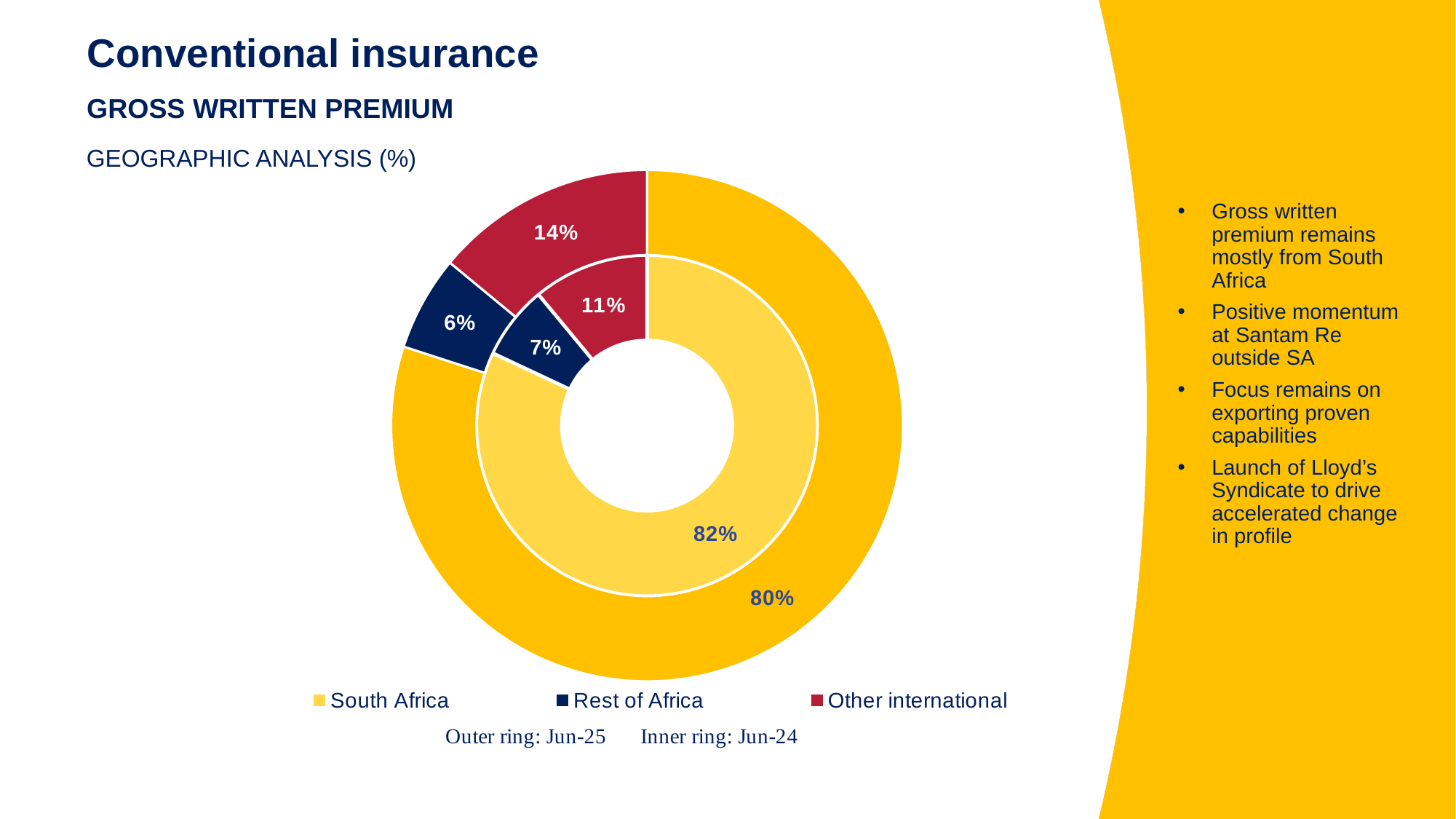
Which region has the smallest share in the inner ring (Jun-24)? Rest of Africa How many regions does the legend list? 3 Is the Other international share larger in the outer ring (Jun-25) or the inner ring (Jun-24)? Outer ring (Jun-25) What is the Rest of Africa share in the outer ring (Jun-25)? 6% What share of gross written premium came from South Africa in the inner ring (Jun-24)? 82% Which region has the largest share in the outer ring (Jun-25)? South Africa What is the Other international share in the inner ring (Jun-24)? 11% What share of gross written premium came from South Africa in the outer ring (Jun-25)? 80% By how many percentage points did the Other international share change from the inner ring (Jun-24) to the outer ring (Jun-25)? 3 percentage points What is the Other international share in the outer ring (Jun-25)? 14% What type of chart is shown on the slide? Doughnut chart What is the Rest of Africa share in the inner ring (Jun-24)? 7%